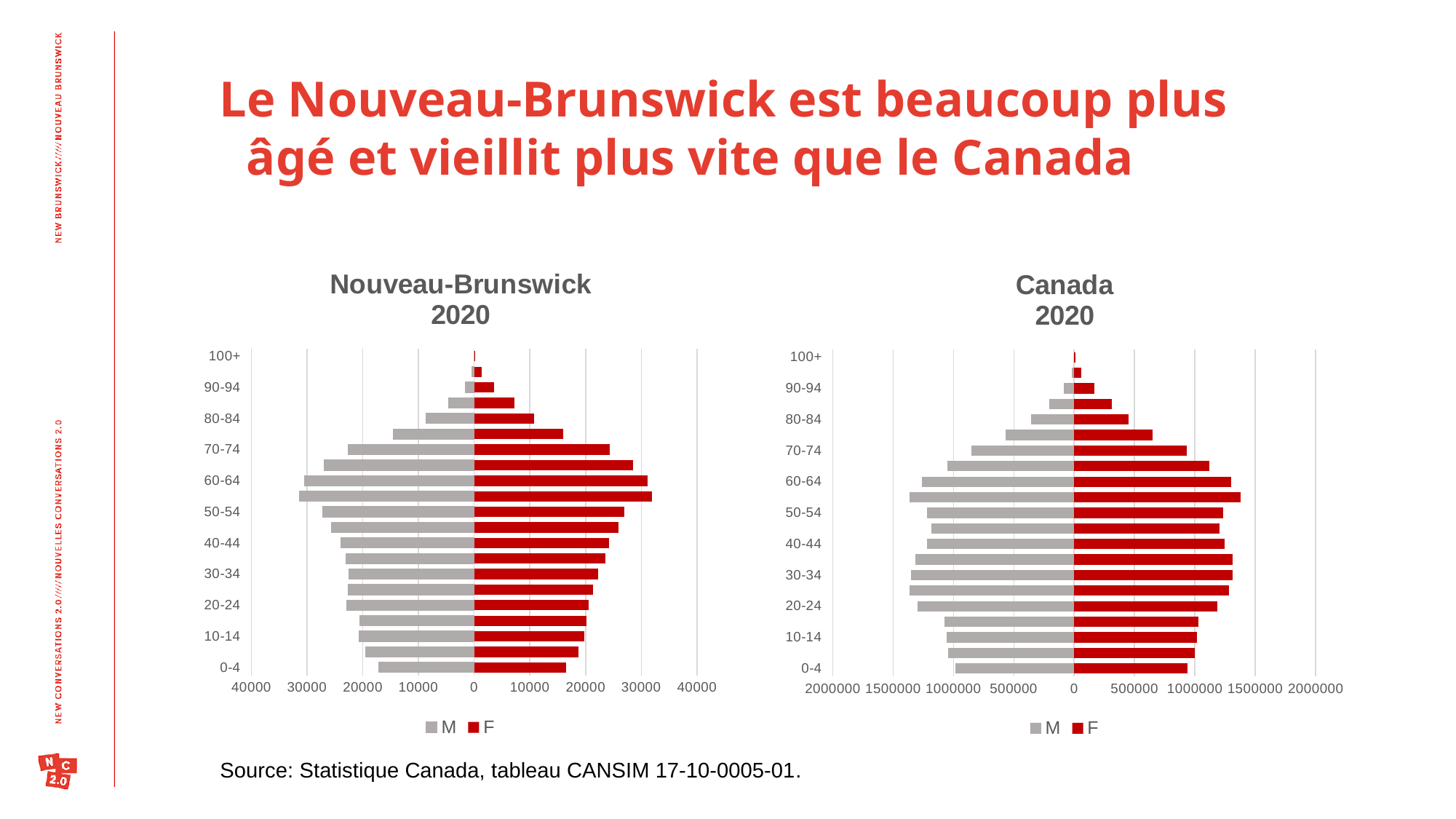
On the Nouveau-Brunswick 2020 chart, which colour represents the F series? red On the Nouveau-Brunswick 2020 chart, which F bar is longer: 60-64 or 0-4? 60-64 What kind of chart is the Nouveau-Brunswick 2020 chart? bar chart On the Nouveau-Brunswick 2020 chart, is the F value for the 70-74 age group greater or less than 20000? greater How many series does the legend of the Canada 2020 chart list? 2 On the Nouveau-Brunswick 2020 chart, is the F value for the 0-4 age group greater or less than 20000? less On the Nouveau-Brunswick 2020 chart, is the M value for the 80-84 age group greater or less than 10000? less On the Canada 2020 chart, which M bar is longer: 20-24 or 80-84? 20-24 What are the two legend entries on the Nouveau-Brunswick 2020 chart? M and F